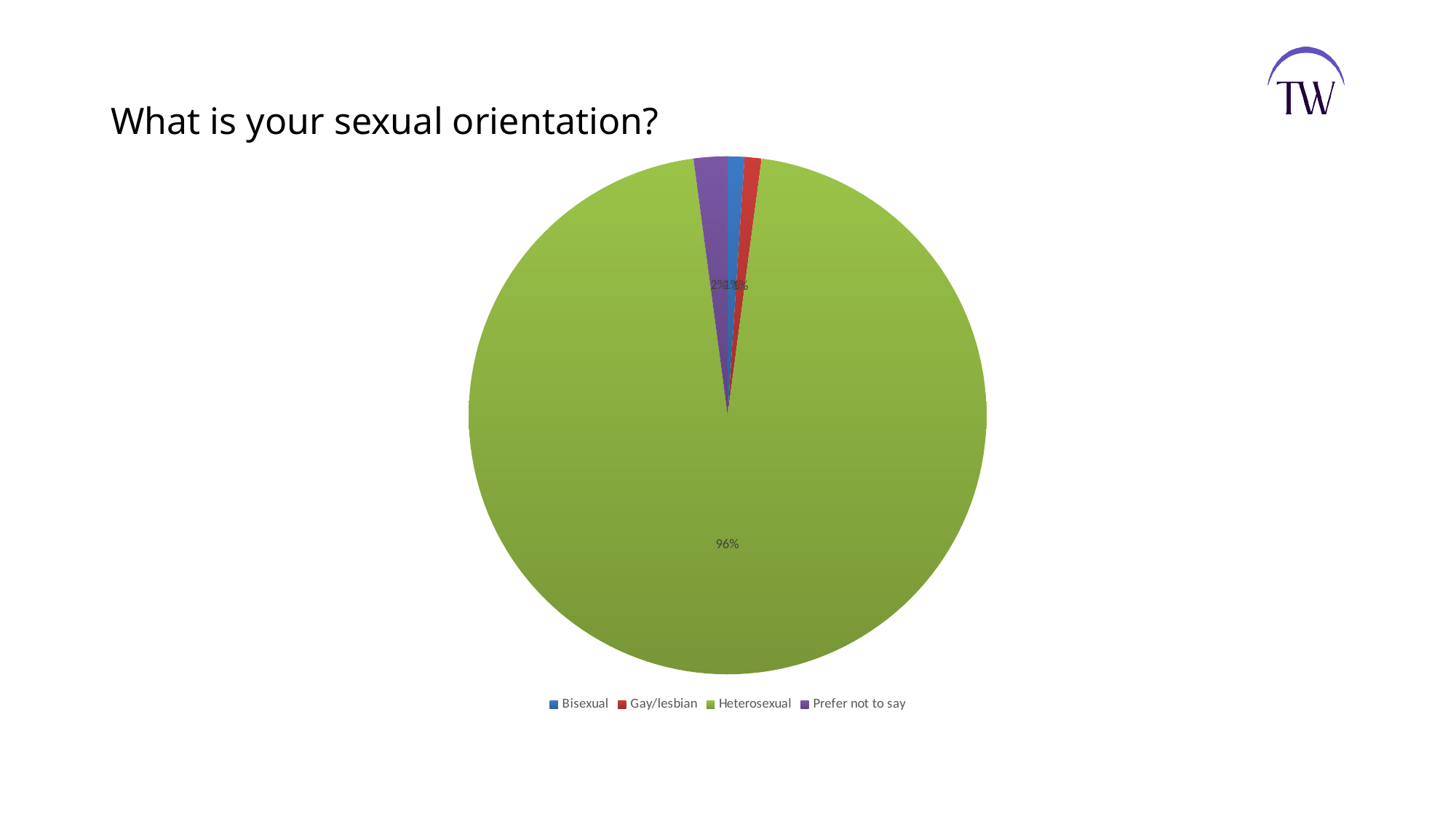
What colour is the Heterosexual slice? green Is the share for Heterosexual greater or less than 50%? greater What percentage of the pie is the Heterosexual slice? 96% Which is larger, the Heterosexual slice or the Bisexual slice? Heterosexual Which is larger, the Heterosexual slice or the Prefer not to say slice? Heterosexual What is the title of the chart? What is your sexual orientation? How many categories does the legend list? 4 Which category has the largest share of the pie? Heterosexual What kind of chart is shown on the slide? pie chart